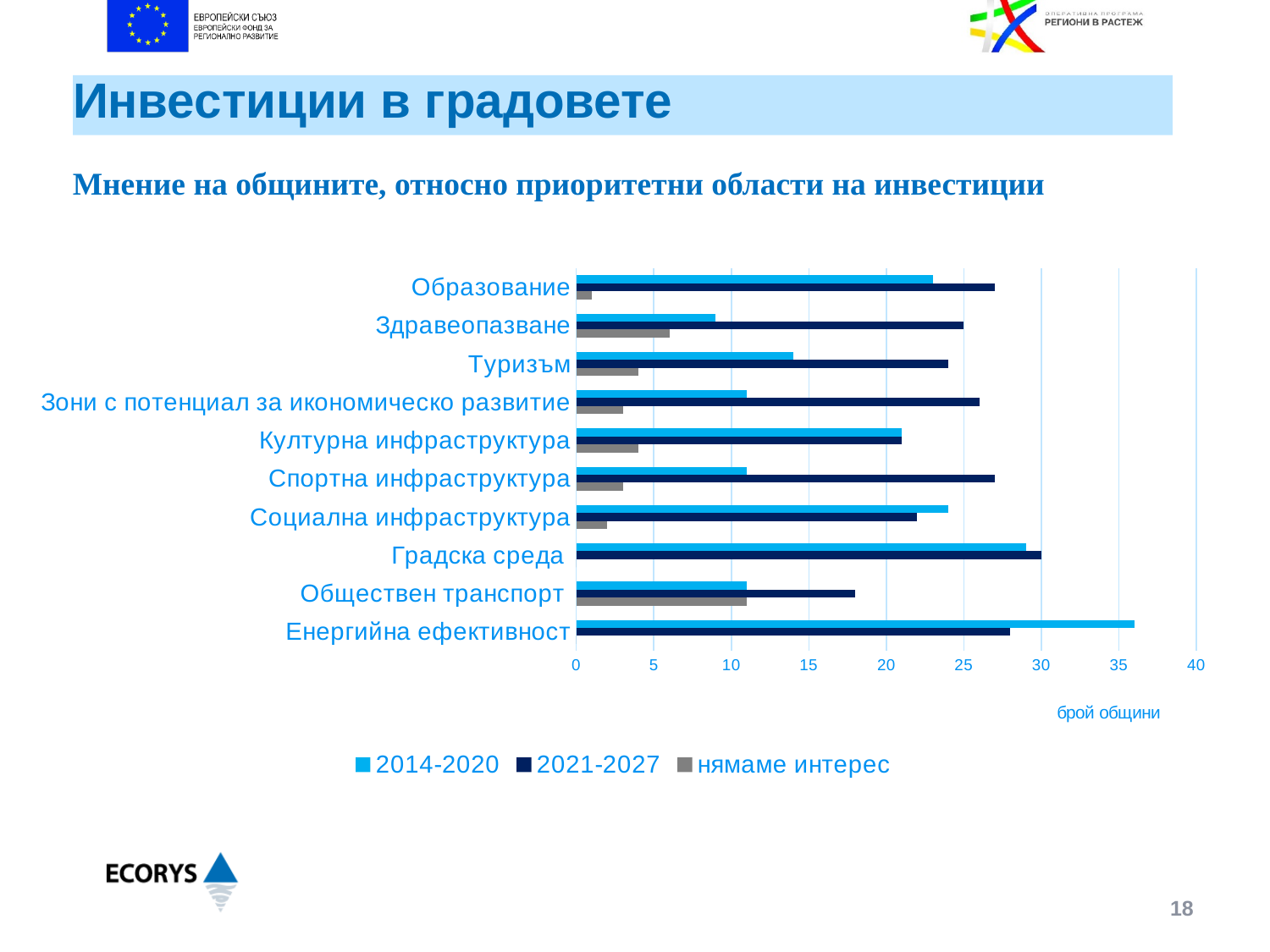
Is the 2014-2020 value for Енергийна ефективност greater or less than 35? greater Which category has the lowest value for the 2014-2020 series? Здравеопазване What is the label of the horizontal axis of the chart? брой общини How many series does the legend list? 3 For Здравеопазване, which series has the larger value: 2014-2020 or 2021-2027? 2021-2027 Which category has the highest value for the нямаме интерес series? Обществен транспорт For Енергийна ефективност, which series has the larger value: 2014-2020 or 2021-2027? 2014-2020 What kind of chart is shown on the slide? bar chart Which category has the highest value for the 2014-2020 series? Енергийна ефективност How many categories (investment areas) are shown on the chart? 10 Is the 2021-2027 value for Обществен транспорт greater or less than 20? less Which category has the highest value for the 2021-2027 series? Градска среда